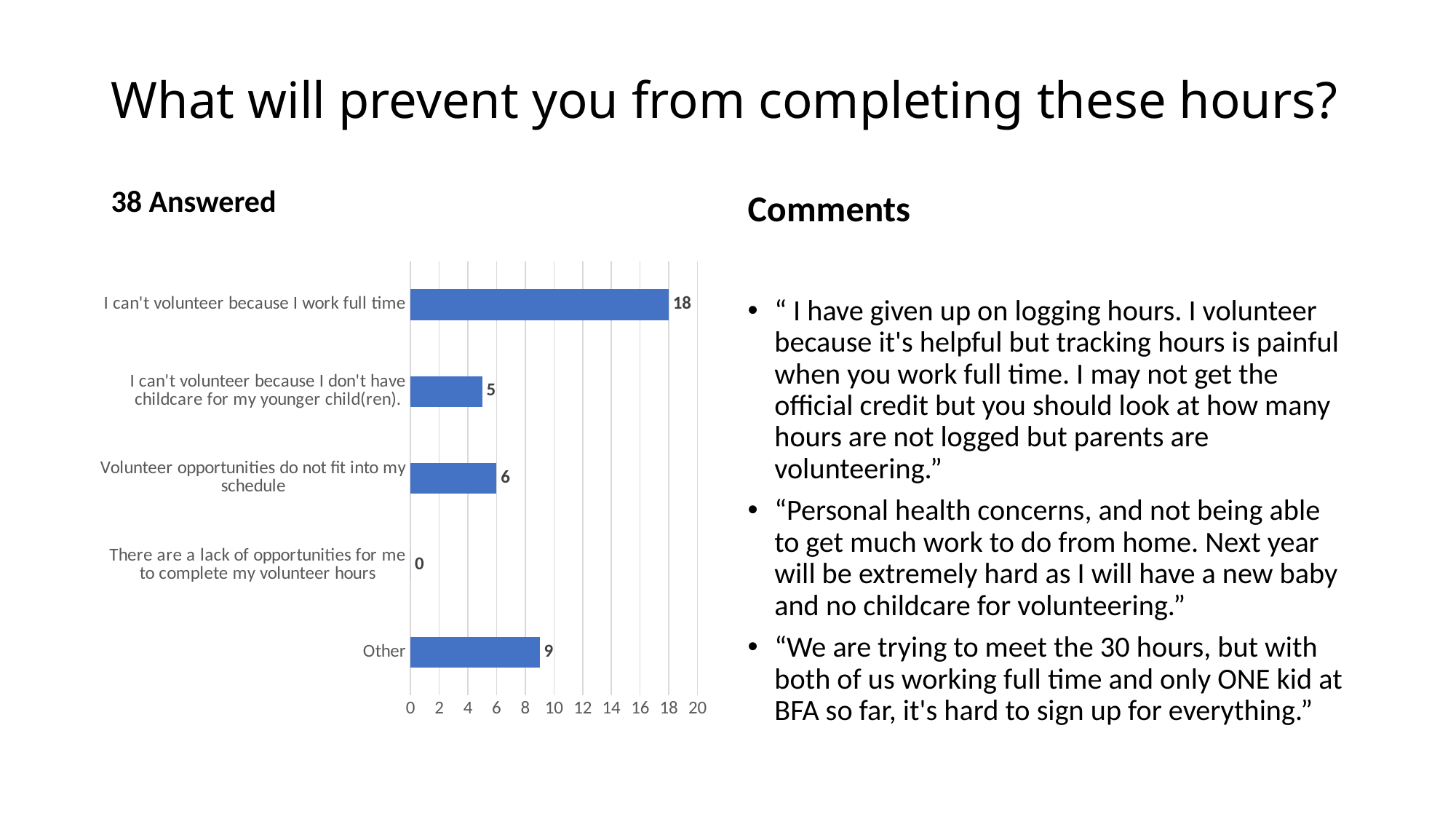
Is the value for "Other" greater or less than 10? less What kind of chart is shown on the slide? bar chart What is the value for "I can't volunteer because I don't have childcare for my younger child(ren)."? 5 What is the difference between the value for "I can't volunteer because I work full time" and the value for "Other"? 9 What is the value for "Volunteer opportunities do not fit into my schedule"? 6 What is the value for "There are a lack of opportunities for me to complete my volunteer hours"? 0 Which category has the lowest value? There are a lack of opportunities for me to complete my volunteer hours Which is larger: the value for "Volunteer opportunities do not fit into my schedule" or the value for "I can't volunteer because I don't have childcare for my younger child(ren)."? Volunteer opportunities do not fit into my schedule What is the value for "I can't volunteer because I work full time"? 18 Which category has the highest value? I can't volunteer because I work full time What is the value for "Other"? 9 How many categories are shown in the chart? 5